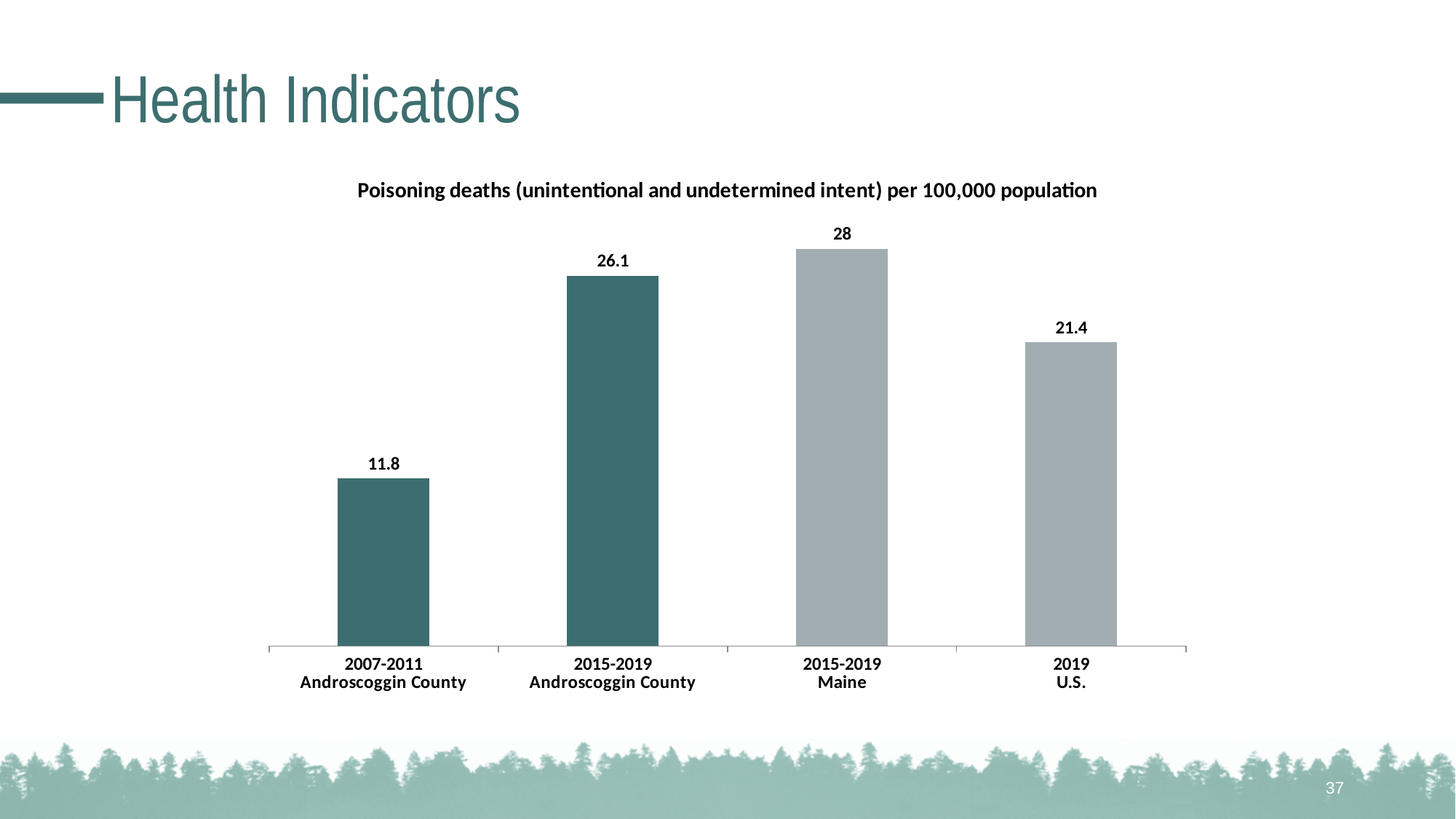
What kind of chart is shown on the slide? Bar chart What is the title of the chart? Poisoning deaths (unintentional and undetermined intent) per 100,000 population Which category has the lowest value? 2007-2011 Androscoggin County What is the value for 2015-2019 Androscoggin County? 26.1 What is the value for 2007-2011 Androscoggin County? 11.8 How many categories are shown in the chart? 4 Which is larger, the value for 2015-2019 Androscoggin County or the value for 2019 U.S.? 2015-2019 Androscoggin County What is the value for 2019 U.S.? 21.4 What is the value for 2015-2019 Maine? 28 Which category has the highest value? 2015-2019 Maine What is the difference between the 2015-2019 Androscoggin County value and the 2007-2011 Androscoggin County value? 14.3 What is the difference between the 2015-2019 Maine value and the 2019 U.S. value? 6.6